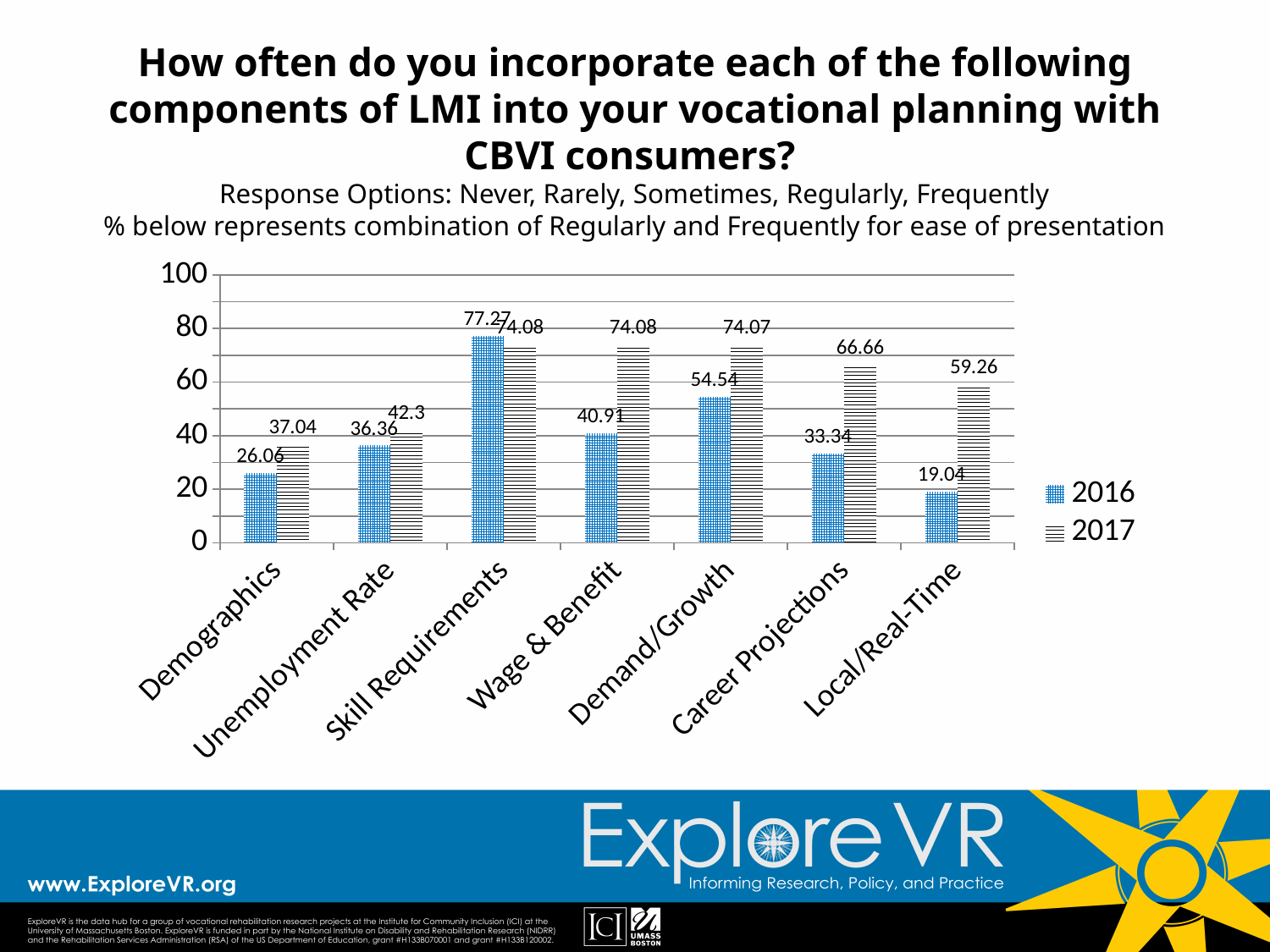
What is the difference between the 2017 and 2016 values for Wage & Benefit? 33.17 What are the two series listed in the legend? 2016 and 2017 What is the 2016 value for Skill Requirements? 77.27 What kind of chart is shown on the slide? bar chart What is the 2017 value for Career Projections? 66.66 Which category has the lowest 2017 value? Demographics How many series does the legend list? 2 Which category has the highest 2016 value? Skill Requirements What is the 2016 value for Local/Real-Time? 19.04 Which is larger for Skill Requirements, the 2016 value or the 2017 value? 2016 Is the 2017 value for Demand/Growth greater or less than 60? greater How many categories are shown on the x axis? 7